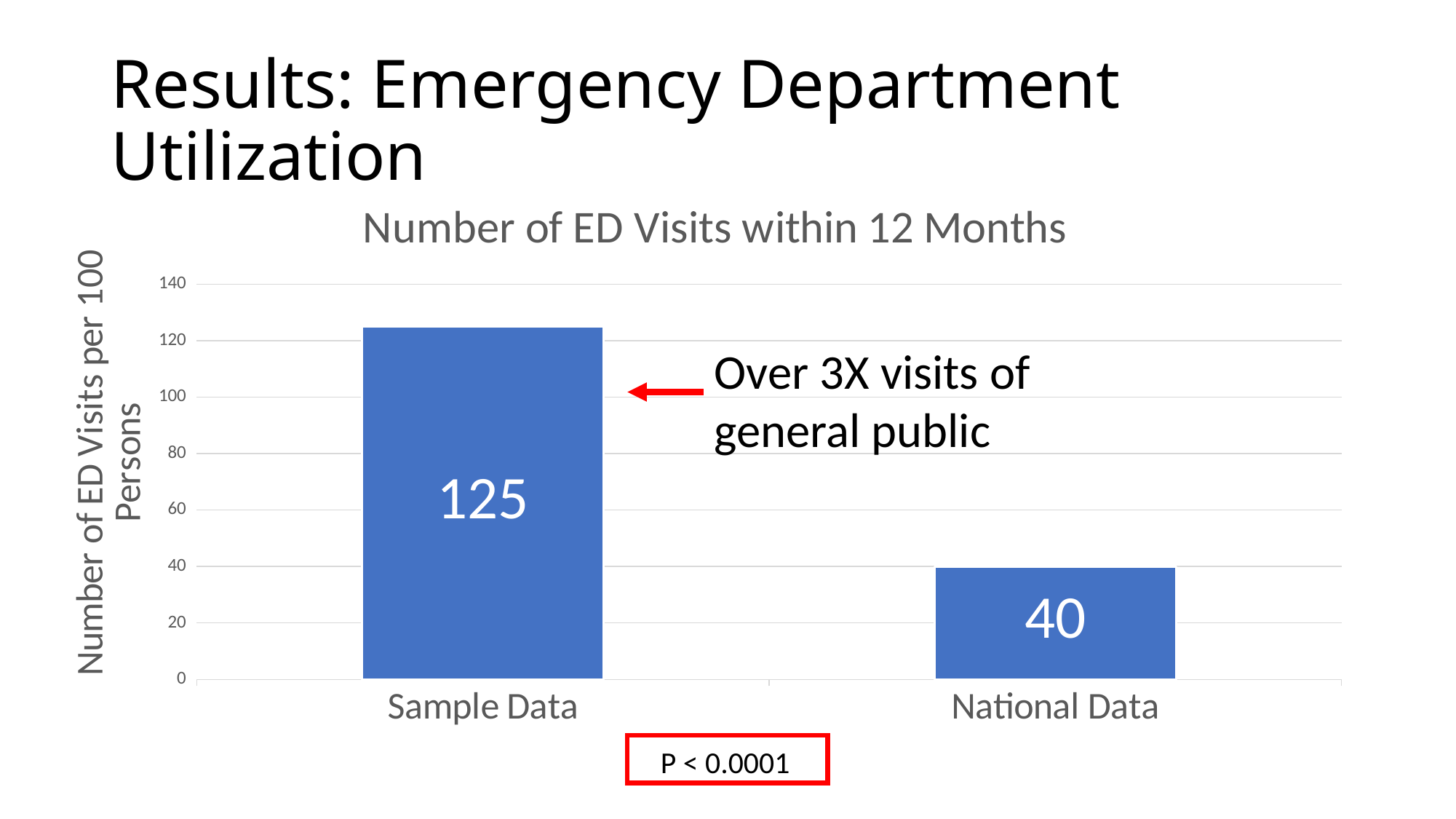
What is the title of the chart? Number of ED Visits within 12 Months What is the value for Sample Data? 125 Which is larger, the value for Sample Data or the value for National Data? Sample Data What is the value for National Data? 40 What is the difference between the Sample Data and National Data values? 85 Is the value for Sample Data greater or less than 100? greater Which category has the highest number of ED visits? Sample Data What is the label of the vertical axis? Number of ED Visits per 100 Persons What kind of chart is shown on the slide? bar chart Which category has the lowest number of ED visits? National Data Is the value for National Data greater or less than 60? less How many categories are shown on the chart? 2